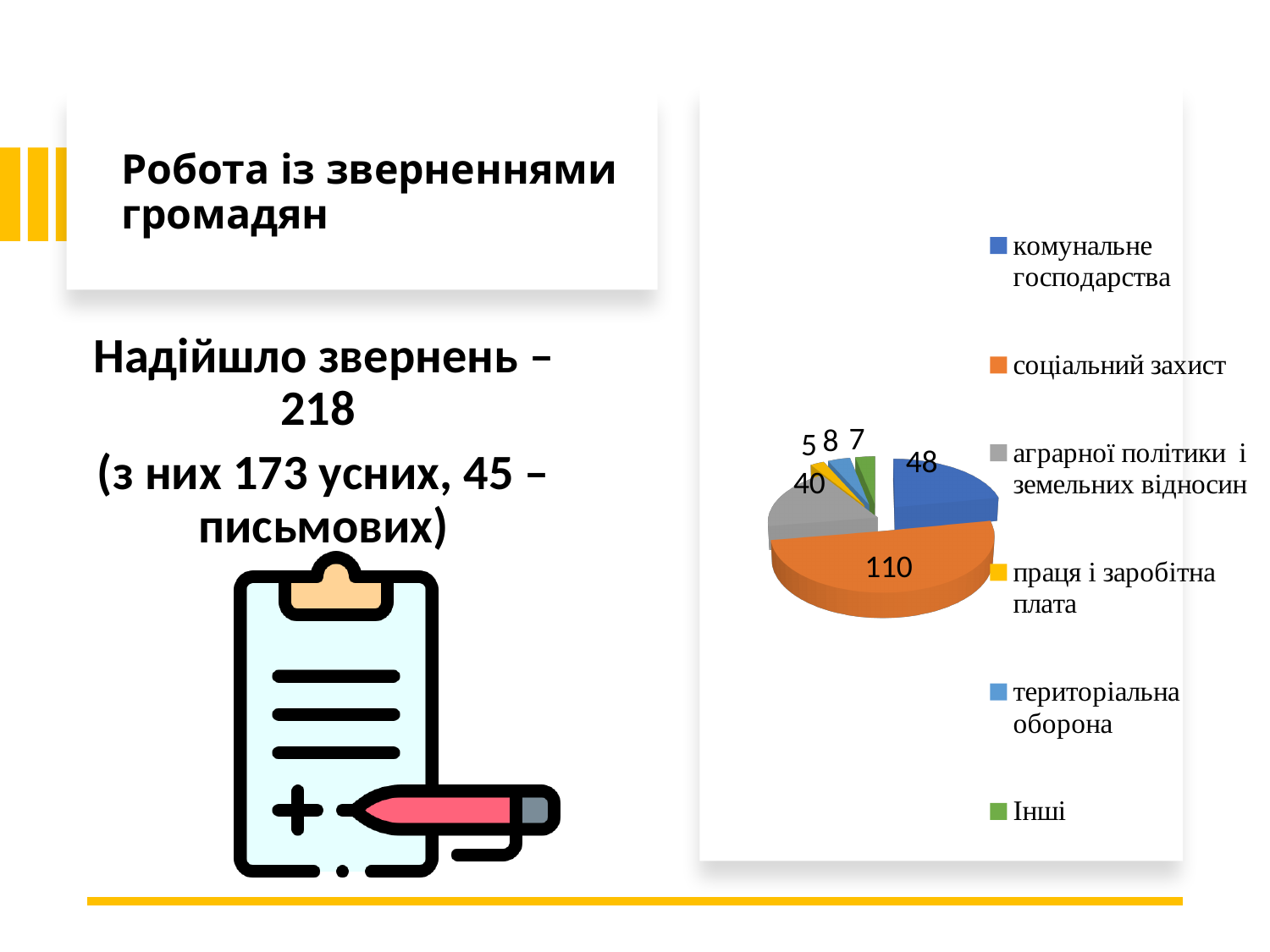
What kind of chart is shown on the slide? pie chart Which category has the largest slice in the pie chart? соціальний захист What is the value for територіальна оборона in the pie chart? 8 What is the difference between the values for соціальний захист and комунальне господарства? 62 Which is larger in the pie chart: територіальна оборона or Інші? територіальна оборона Which category has the smallest slice in the pie chart? праця і заробітна плата What is the value for комунальне господарства in the pie chart? 48 What is the value for аграрної політики і земельних відносин in the pie chart? 40 What is the value for праця і заробітна плата in the pie chart? 5 How many categories does the pie chart show? 6 What is the value for соціальний захист in the pie chart? 110 What colour is the slice for соціальний захист in the pie chart? orange